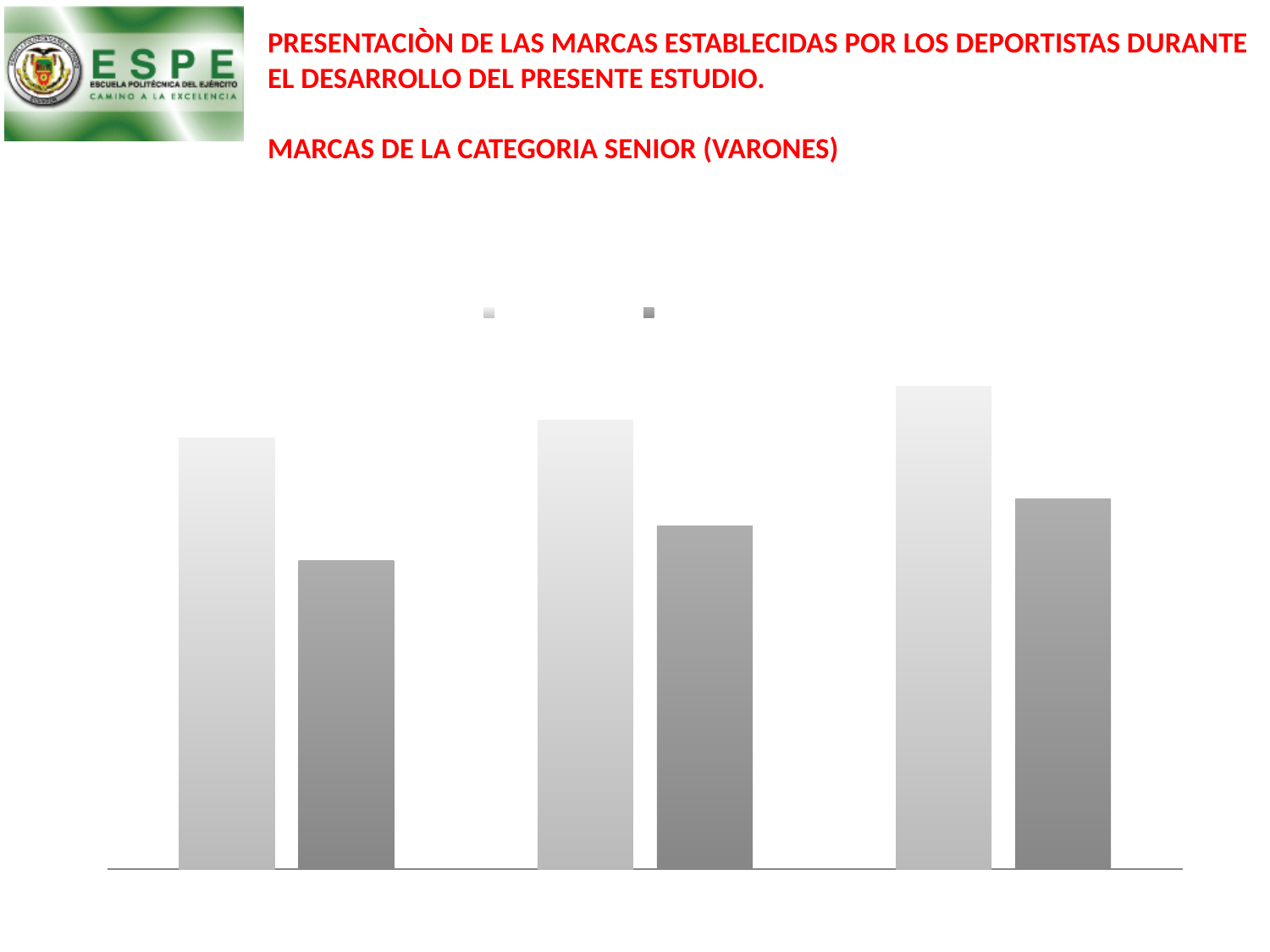
In the first group of bars, which is taller: the light grey bar or the dark grey bar? the light grey bar Do the dark grey bars rise or fall from left to right across the groups? rise Which group of bars has the shortest light grey bar? the first group How many series does the chart's legend list? 2 Which group of bars has the tallest light grey bar? the third group What two colours are used for the bars in the chart? light grey and dark grey In the third group of bars, which is taller: the light grey bar or the dark grey bar? the light grey bar Do the light grey bars rise or fall from left to right across the groups? rise What kind of chart is shown on the slide? bar chart How many groups of bars are plotted in the chart? 3 Which group of bars has the shortest dark grey bar? the first group